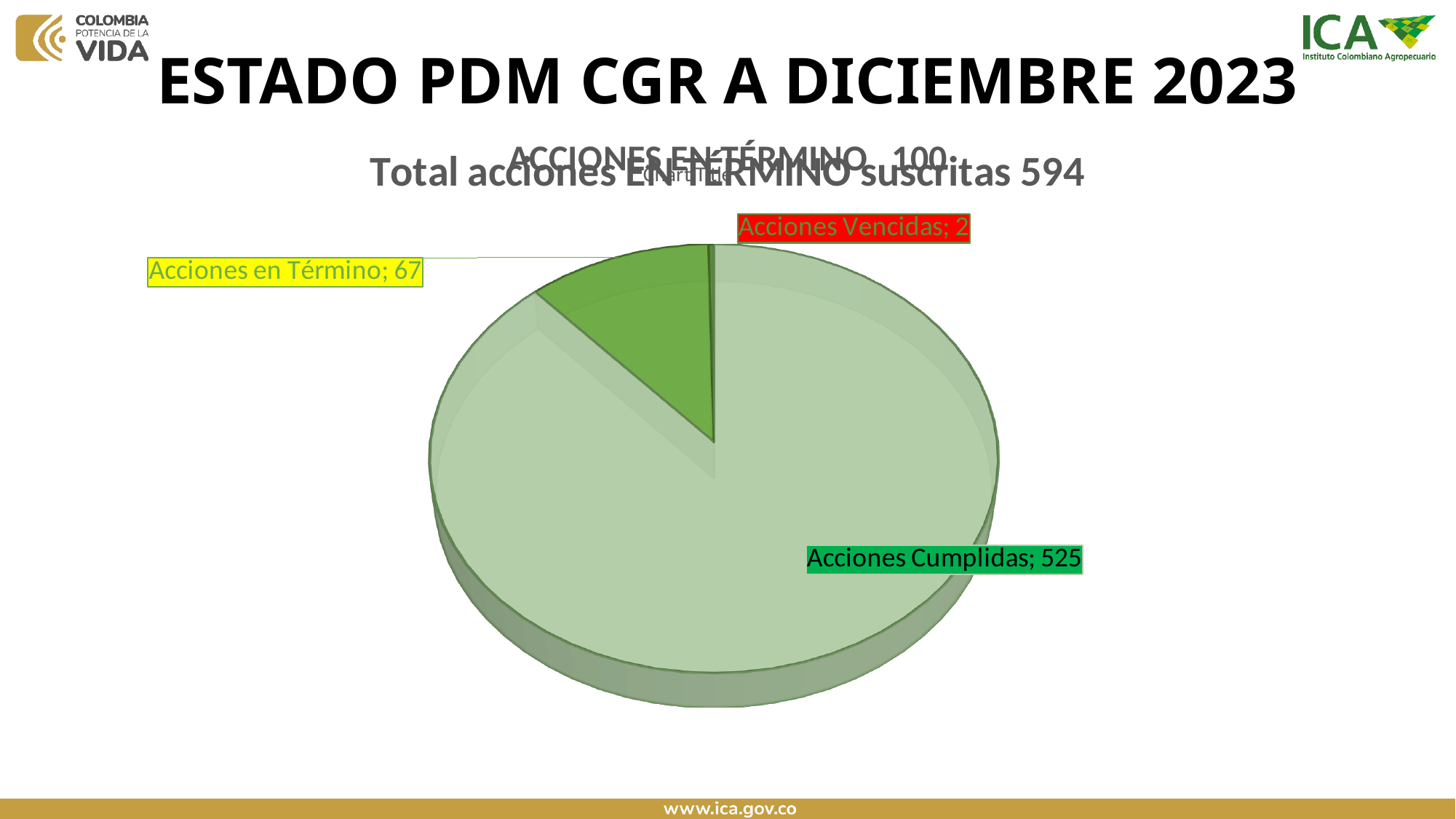
What is the total of all three slices in the pie chart? 594 What kind of chart is shown on the slide? pie chart Which is larger, Acciones Cumplidas or Acciones en Término? Acciones Cumplidas What colour is the background of the Acciones Vencidas data label? red Which category has the largest slice of the pie? Acciones Cumplidas What is the value for Acciones Vencidas? 2 What is the difference between Acciones en Término and Acciones Vencidas? 65 Which category has the smallest slice of the pie? Acciones Vencidas What is the value for Acciones Cumplidas? 525 What is the difference between Acciones Cumplidas and Acciones en Término? 458 How many categories are shown in the pie chart? 3 What is the value for Acciones en Término? 67